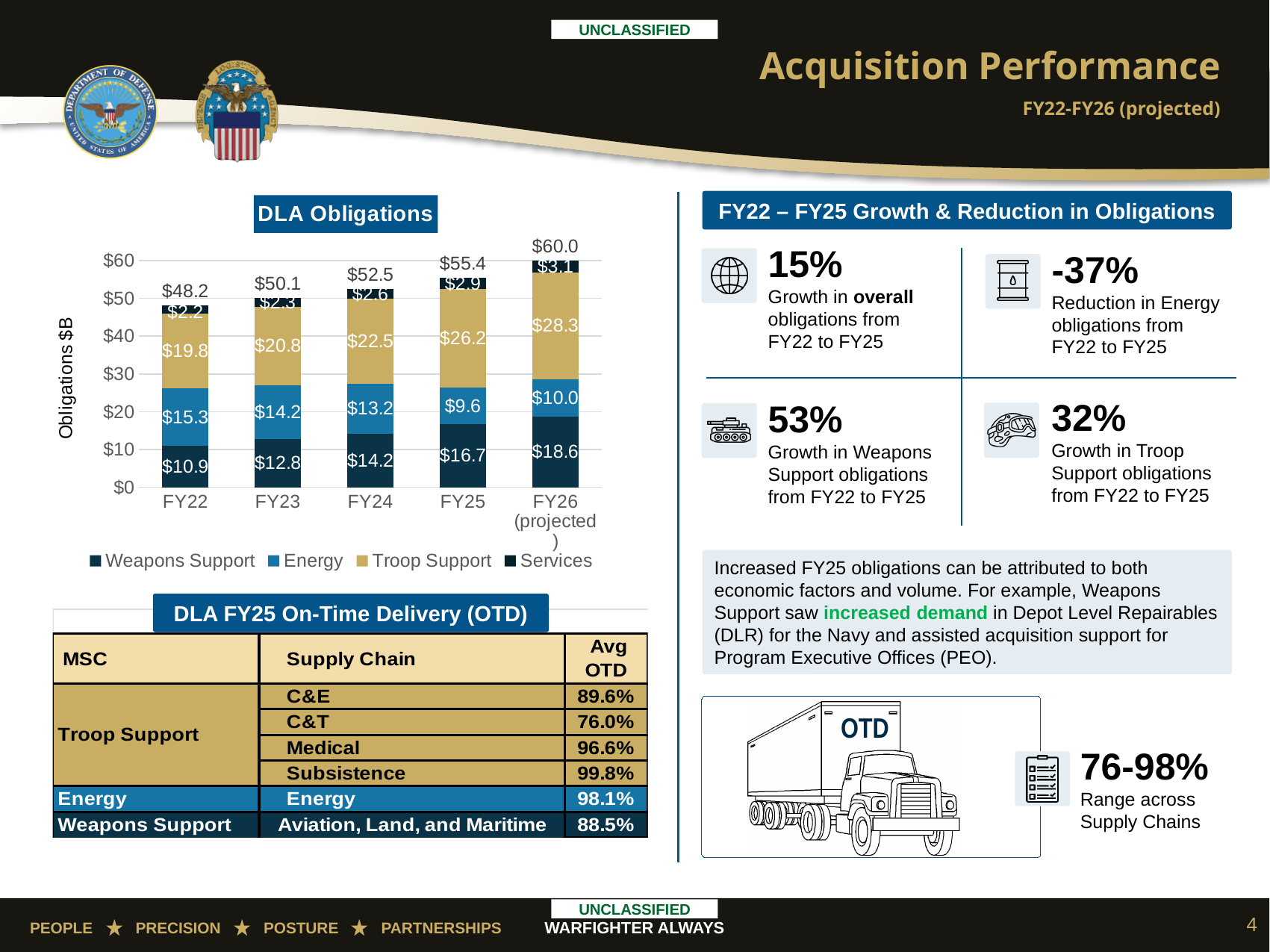
In the DLA Obligations chart, which fiscal year has the highest Weapons Support value? FY26 (projected) In the DLA Obligations chart, which fiscal year has the lowest total obligations? FY22 In the DLA Obligations chart, what is the Troop Support value for FY24? $22.5 In the DLA Obligations chart, what is the difference between the total obligations for FY25 and FY22? $7.2 What type of chart is the DLA Obligations chart? Stacked bar chart How many fiscal years are shown on the x axis of the DLA Obligations chart? 5 In the DLA Obligations chart, do total obligations rise or fall from FY22 to FY26 (projected)? Rise In the DLA Obligations chart, what is the Weapons Support value for FY22? $10.9 In the DLA Obligations chart, what is the Energy value for FY25? $9.6 In the DLA Obligations chart, is the Energy value larger in FY22 or FY25? FY22 In the DLA Obligations chart, what is the total obligations value shown for FY26 (projected)? $60.0 How many series does the legend of the DLA Obligations chart list? 4